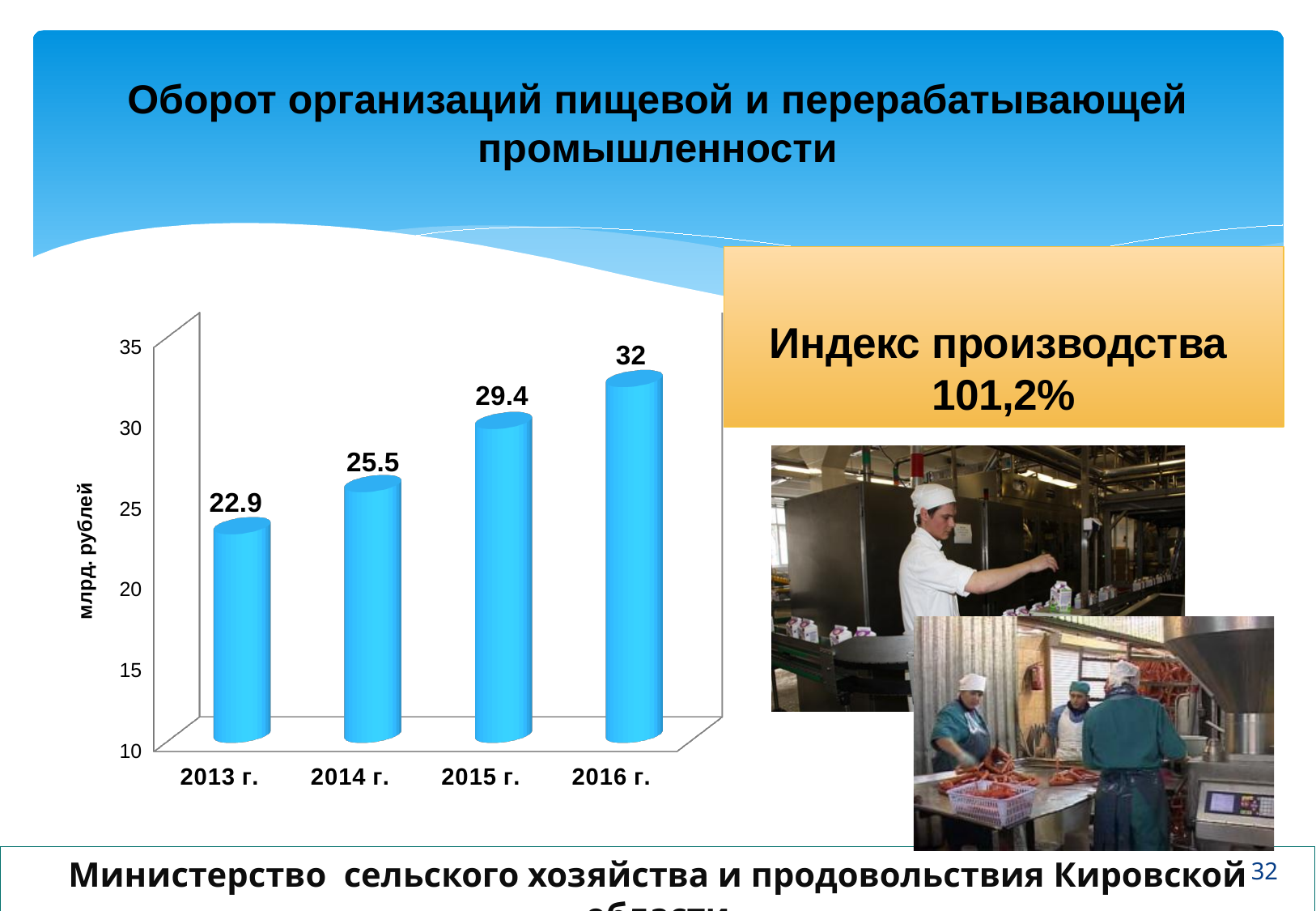
Do the values rise or fall from 2013 г. to 2016 г.? rise How many years are shown on the chart? 4 Is the value for 2014 г. greater or less than 25? greater Which is larger, the value for 2014 г. or the value for 2015 г.? 2015 г. What kind of chart is shown on the slide? bar chart What is the value for 2013 г.? 22.9 Which year has the highest value? 2016 г. Which year has the lowest value? 2013 г. What is the value for 2016 г.? 32 What is the difference between the values for 2015 г. and 2014 г.? 3.9 What is the difference between the values for 2016 г. and 2013 г.? 9.1 What is the value for 2015 г.? 29.4